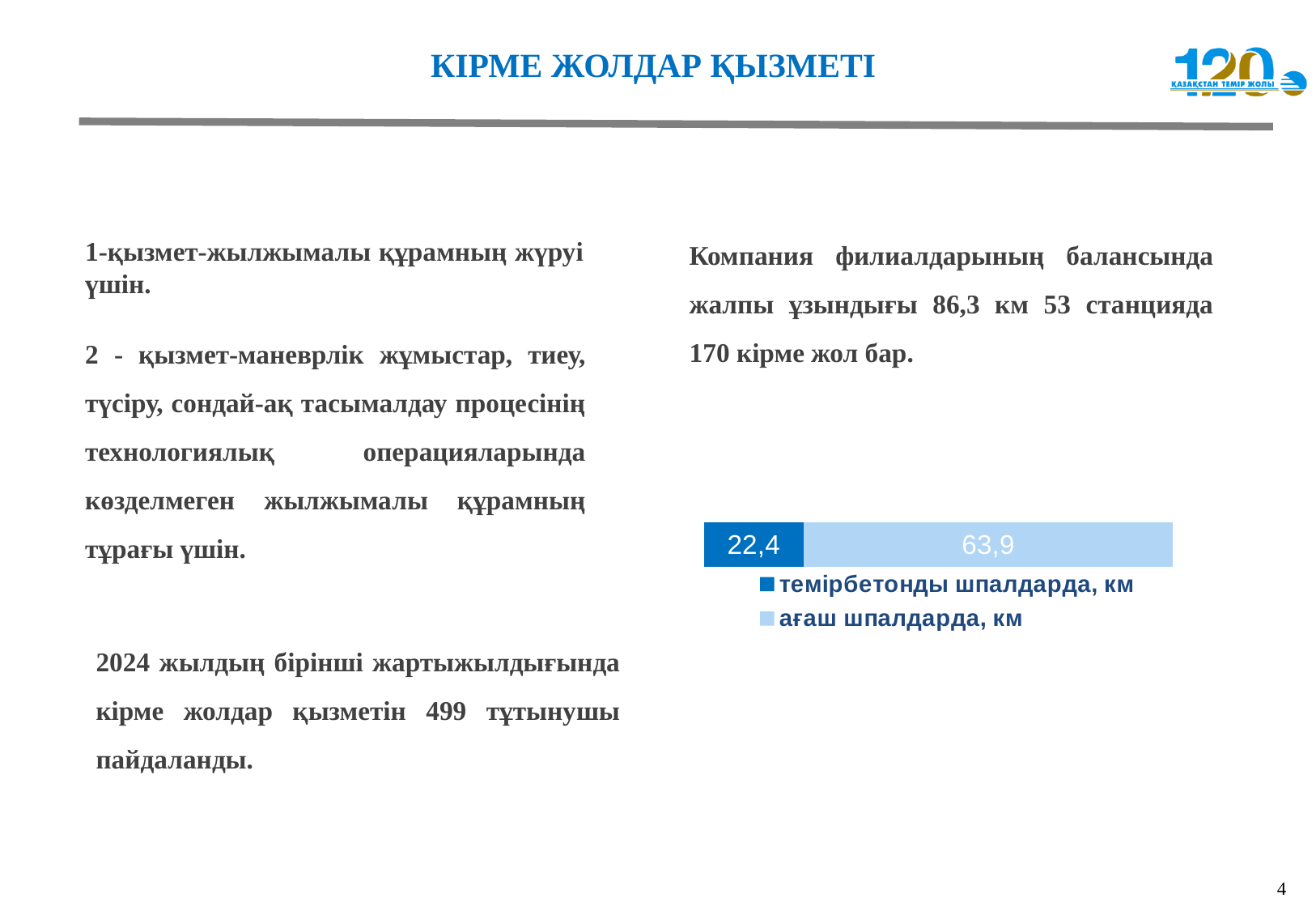
Which series has the largest value in the chart? ағаш шпалдарда, км What is the value for темірбетонды шпалдарда, км in the chart? 22,4 What is the total of the stacked bar in the chart? 86,3 Which legend entry is shown in dark blue in the chart? темірбетонды шпалдарда, км What kind of chart is shown on the slide? Stacked bar chart Which series has the smallest value in the chart? темірбетонды шпалдарда, км Which legend entry is shown in light blue in the chart? ағаш шпалдарда, км What is the value for ағаш шпалдарда, км in the chart? 63,9 Which series has the larger value in the chart, темірбетонды шпалдарда or ағаш шпалдарда? ағаш шпалдарда, км What is the difference between the value for ағаш шпалдарда, км and темірбетонды шпалдарда, км? 41,5 How many series does the legend of the chart list? 2